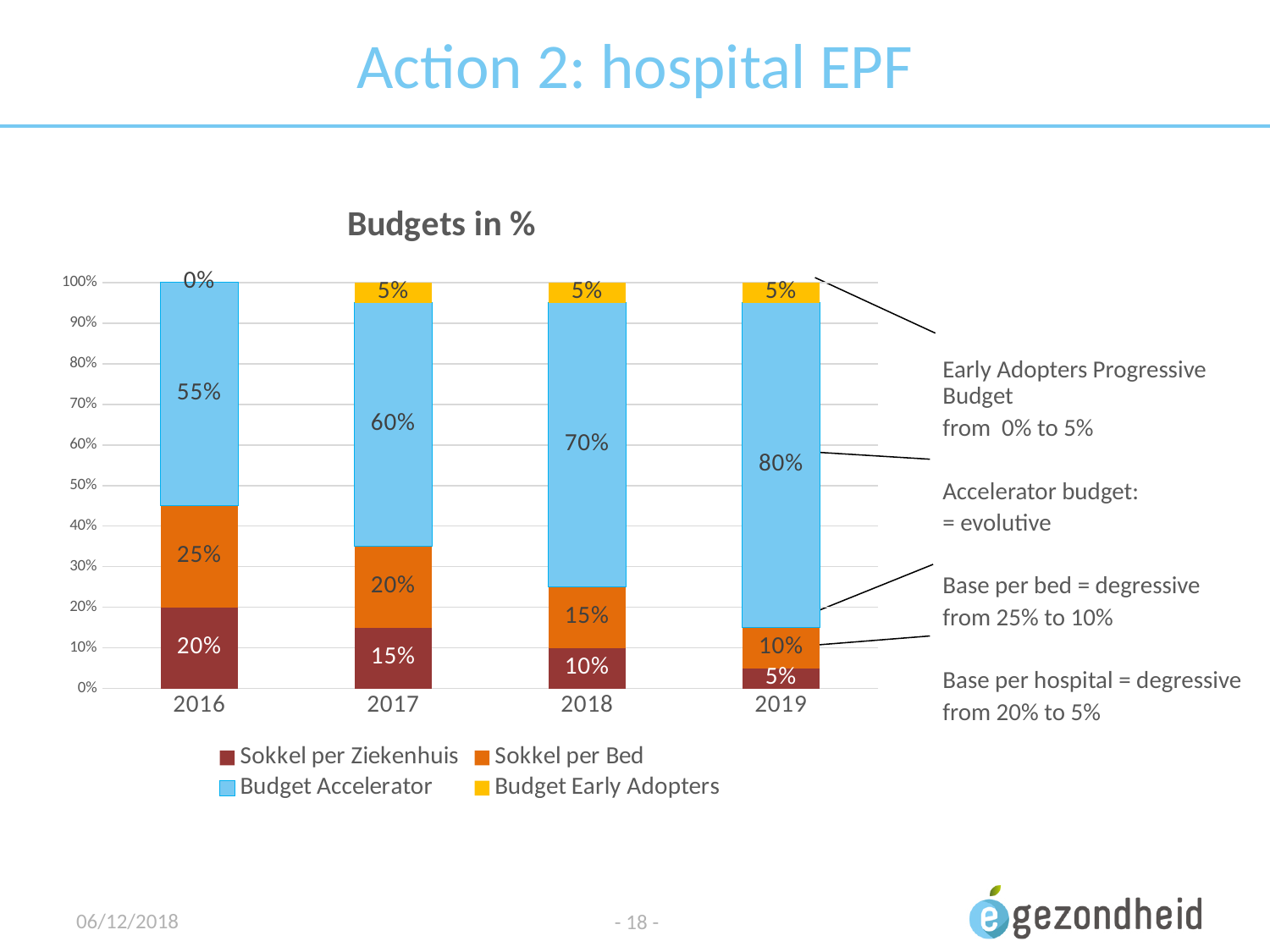
How many years are shown on the x axis? 4 What is the value for Budget Early Adopters in 2016? 0% What kind of chart is shown? Stacked bar chart What is the value for Sokkel per Bed in 2018? 15% In which year is the Budget Accelerator value highest? 2019 What is the value for Sokkel per Ziekenhuis in 2016? 20% What is the difference between the Budget Accelerator values for 2019 and 2016? 25% What is the value for Budget Accelerator in 2019? 80% Does the Sokkel per Bed value rise or fall from 2016 to 2019? Fall Which is larger: Sokkel per Bed in 2017 or Sokkel per Bed in 2019? Sokkel per Bed in 2017 In which year is the Sokkel per Ziekenhuis value lowest? 2019 How many series does the legend list? 4